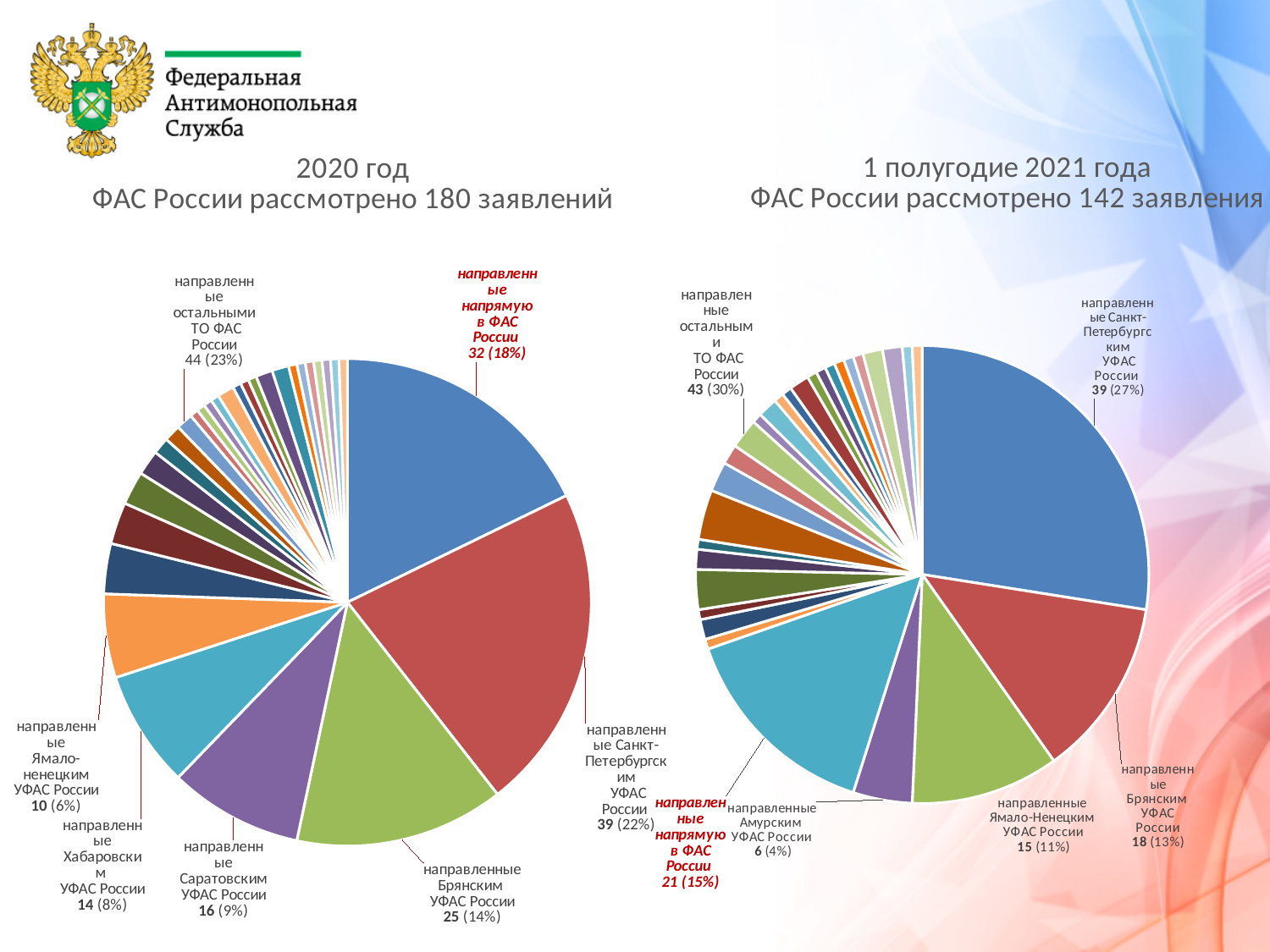
In the 1 полугодие 2021 года chart, what share of applications were направленные напрямую в ФАС России? 15% In the 1 полугодие 2021 года chart, how many applications were направленные Амурским УФАС России? 6 In the 2020 год chart, what is the difference between the number of applications направленные Саратовским УФАС России and направленные Хабаровским УФАС России? 2 In the 2020 год chart, which is larger: applications направленные Ямало-Ненецким УФАС России or направленные Хабаровским УФАС России? направленные Хабаровским УФАС России According to the title of the right chart, how many applications did ФАС России consider in 1 полугодие 2021 года? 142 In the 1 полугодие 2021 года chart, how many applications were направленные Санкт-Петербургским УФАС России? 39 According to the title of the left chart, how many applications did ФАС России consider in 2020 год? 180 In the 2020 год chart, how many applications were направленные Брянским УФАС России? 25 In the 2020 год chart, what share of applications were направленные Санкт-Петербургским УФАС России? 22% In the 1 полугодие 2021 года chart, what is the difference between applications направленные Брянским УФАС России and направленные Ямало-Ненецким УФАС России? 3 What kind of chart is used on the left side of the slide for 2020 год? pie chart In the 2020 год chart, how many applications were направленные напрямую в ФАС России? 32